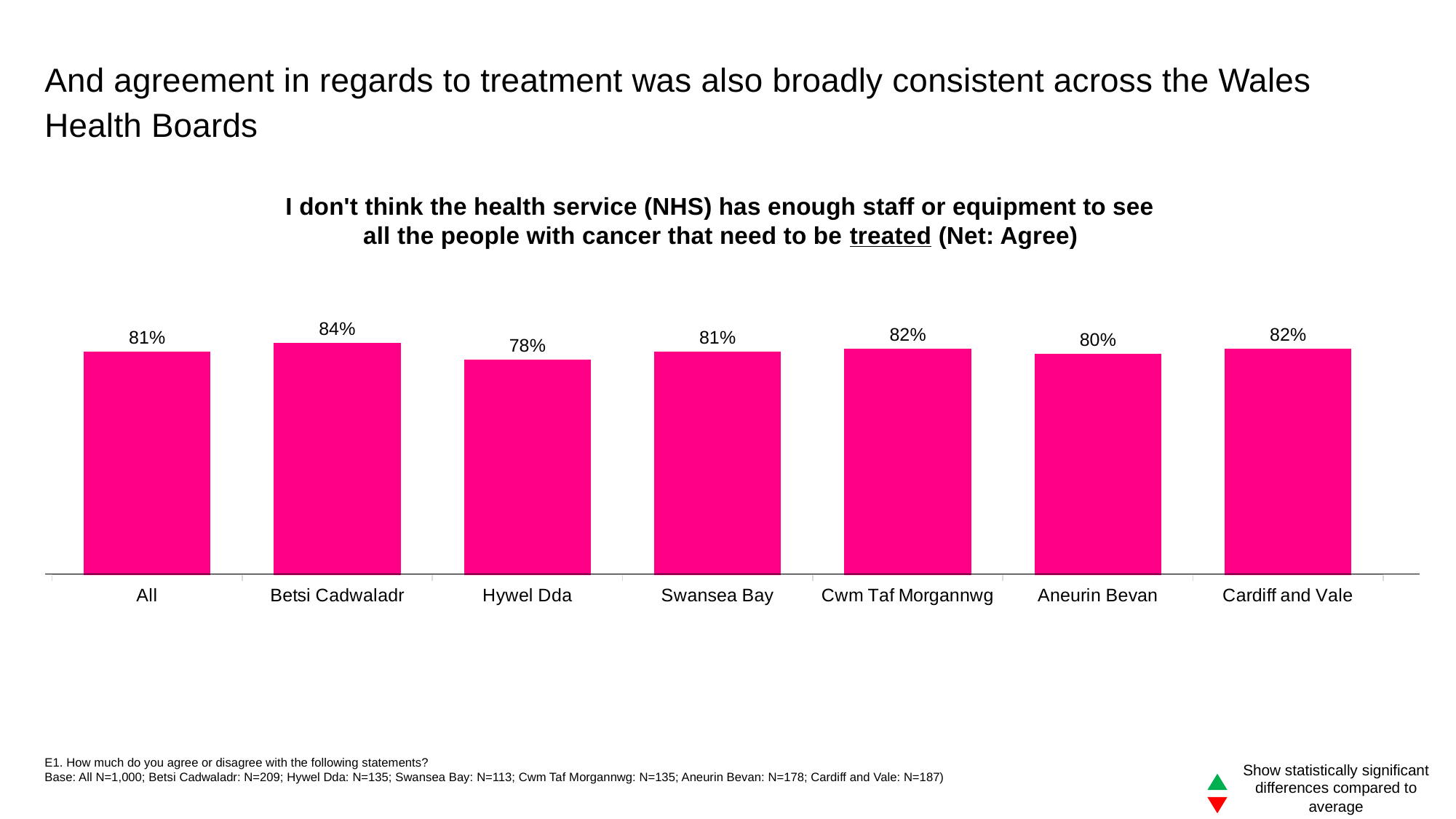
What is the value for Aneurin Bevan? 80% What is the difference between the values for Betsi Cadwaladr and Hywel Dda? 6% What is the difference between the values for Cwm Taf Morgannwg and Aneurin Bevan? 2% What is the value for Hywel Dda? 78% What is the value for Betsi Cadwaladr? 84% Which category has the lowest value? Hywel Dda What kind of chart is shown on the slide? Bar chart How many categories are shown on the chart? 7 What colour are the bars in the chart? Pink Which is larger, the value for Cardiff and Vale or the value for Hywel Dda? Cardiff and Vale What is the value for the All category? 81% Which category has the highest value? Betsi Cadwaladr